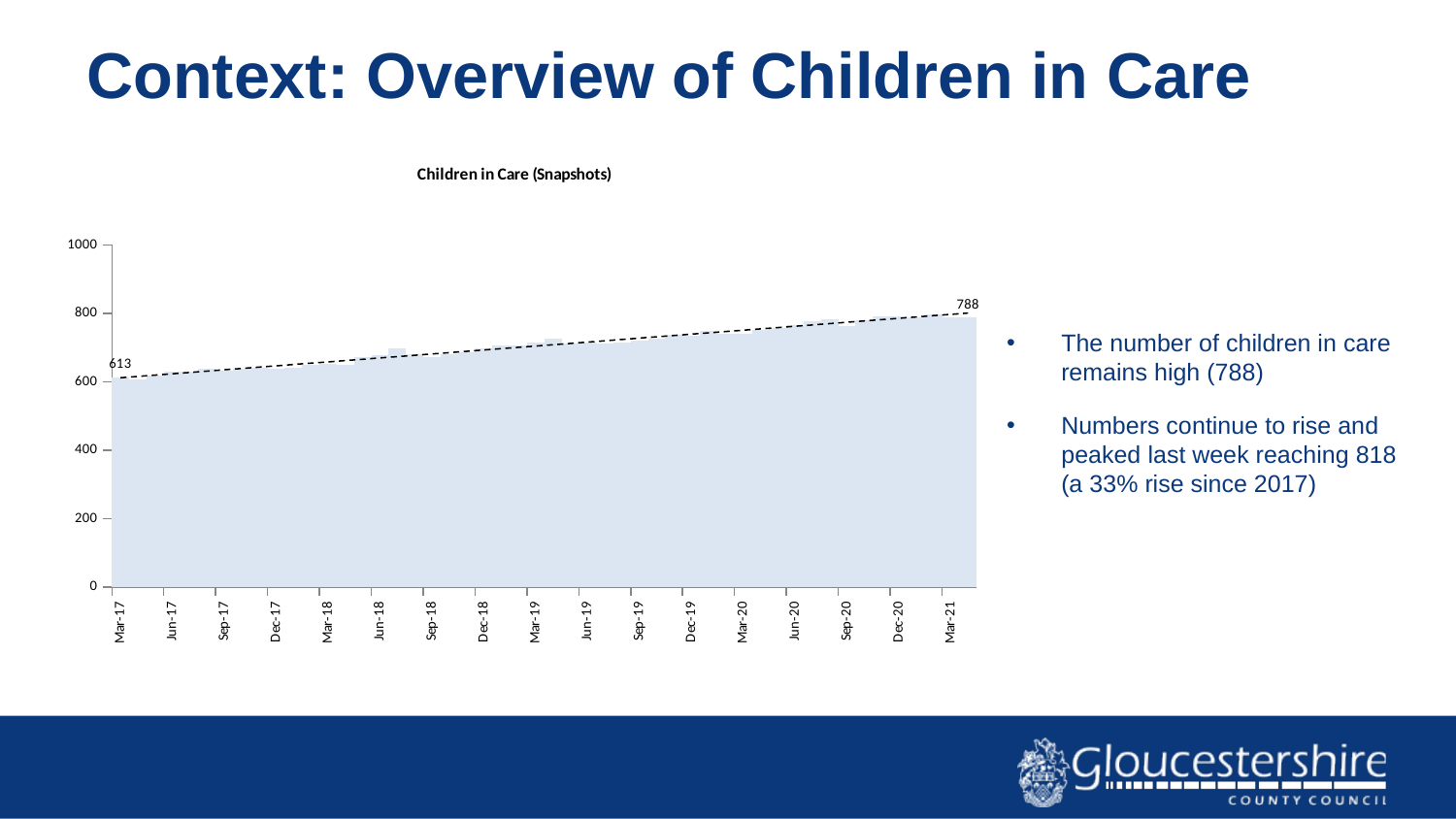
How many time points are shown on the x axis? 17 What is the title of the chart? Children in Care (Snapshots) What is the value for Mar-17? 613 Do the values rise or fall from Mar-17 to Mar-21? Rise Is the value for Mar-19 greater or less than 600? greater What type of chart is shown on the slide? Bar chart What is the value for Mar-21? 788 What is the difference between the values for Mar-21 and Mar-17? 175 Which is larger, the value for Mar-17 or the value for Mar-21? Mar-21 Is the value for Mar-21 greater or less than 800? less